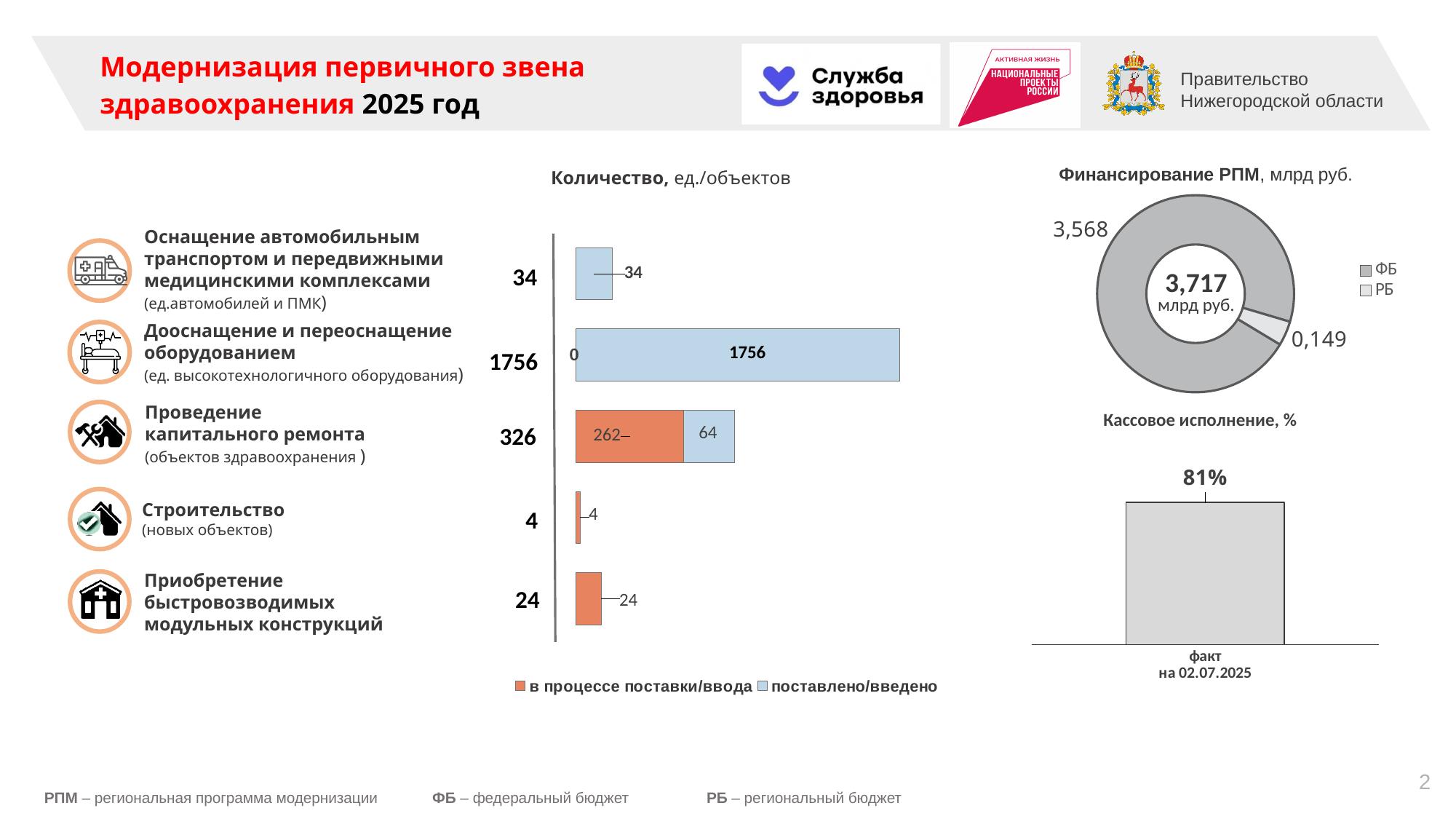
In the chart titled "Количество, ед./объектов", what is the difference between the "в процессе поставки/ввода" and "поставлено/введено" values for "Проведение капитального ремонта"? 198 In the chart titled "Количество, ед./объектов", how many series does the legend list? 2 In the chart titled "Финансирование РПМ, млрд руб.", what is the value for ФБ? 3,568 In the chart titled "Количество, ед./объектов", what is the value of "поставлено/введено" for "Дооснащение и переоснащение оборудованием"? 1756 In the chart titled "Количество, ед./объектов", how many categories are shown? 5 In the chart titled "Количество, ед./объектов", which category has the highest total? Дооснащение и переоснащение оборудованием In the chart titled "Количество, ед./объектов", what is the value of "в процессе поставки/ввода" for "Проведение капитального ремонта"? 262 In the chart titled "Финансирование РПМ, млрд руб.", what is the value for РБ? 0,149 In the chart titled "Количество, ед./объектов", what is the total for "Проведение капитального ремонта"? 326 In the chart titled "Финансирование РПМ, млрд руб.", what total is shown in the centre of the donut? 3,717 млрд руб. In the chart titled "Кассовое исполнение, %", what is the value for "факт на 02.07.2025"? 81% In the chart titled "Количество, ед./объектов", which category has the lowest total? Строительство